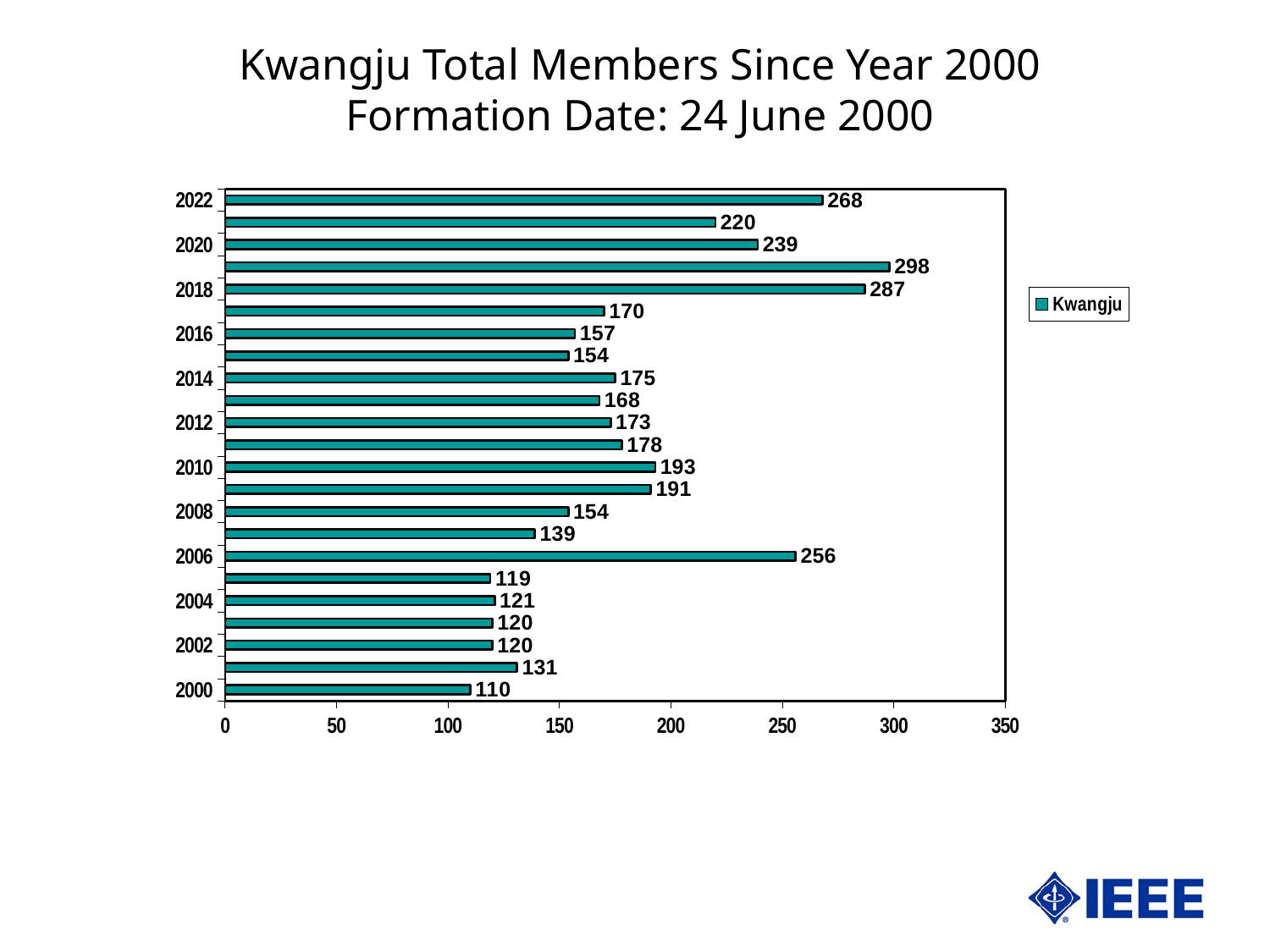
What is the difference between the values for 2022 and 2020? 29 Is the value for 2008 greater or less than 150? greater Which is larger, the value for 2010 or the value for 2012? 2010 What is the value for 2018? 287 What is the value for 2006? 256 How many bars are plotted on the chart? 23 What series name does the legend show? Kwangju What is the value for 2000? 110 What kind of chart is shown? bar chart Which year has the lowest value? 2000 What is the highest value shown on the chart? 298 What is the value for 2022? 268